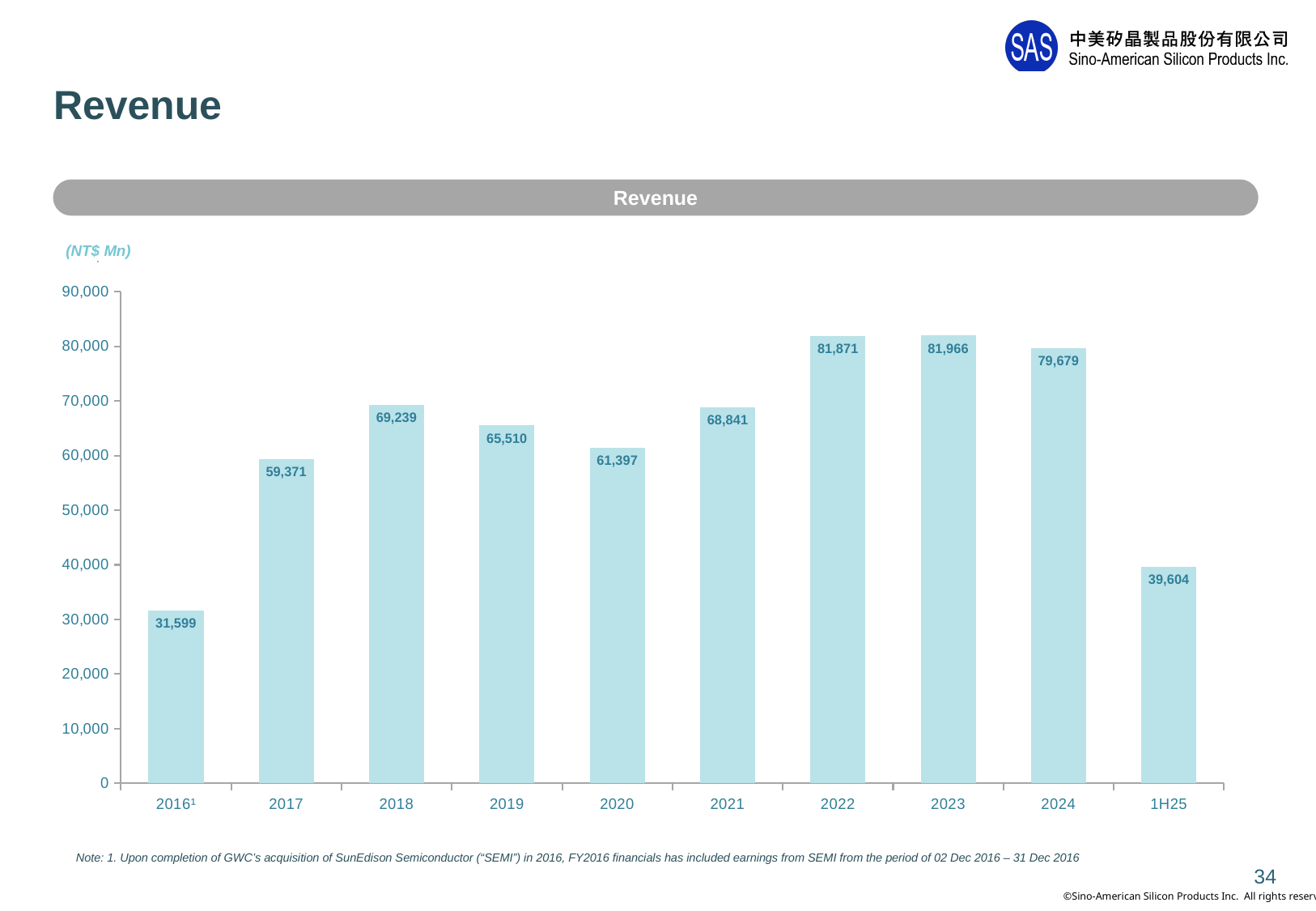
What is the revenue value shown for 2022? 81,871 What kind of chart is used to show revenue on this slide? bar chart What is the difference between the revenue for 2018 and the revenue for 2017? 9,868 How many periods are shown on the x axis of the chart? 10 What is the revenue value shown for 1H25? 39,604 What is the revenue value shown for 2019? 65,510 In what unit are the revenue values on the chart expressed? NT$ Mn Does revenue rise or fall from 2016 to 2018? rise Is the revenue value for 2024 greater or less than 70,000? greater Which is larger, the revenue for 2018 or the revenue for 2019? 2018 Which period has the lowest revenue in the chart? 2016 What is the difference between the revenue for 2023 and the revenue for 2024? 2,287